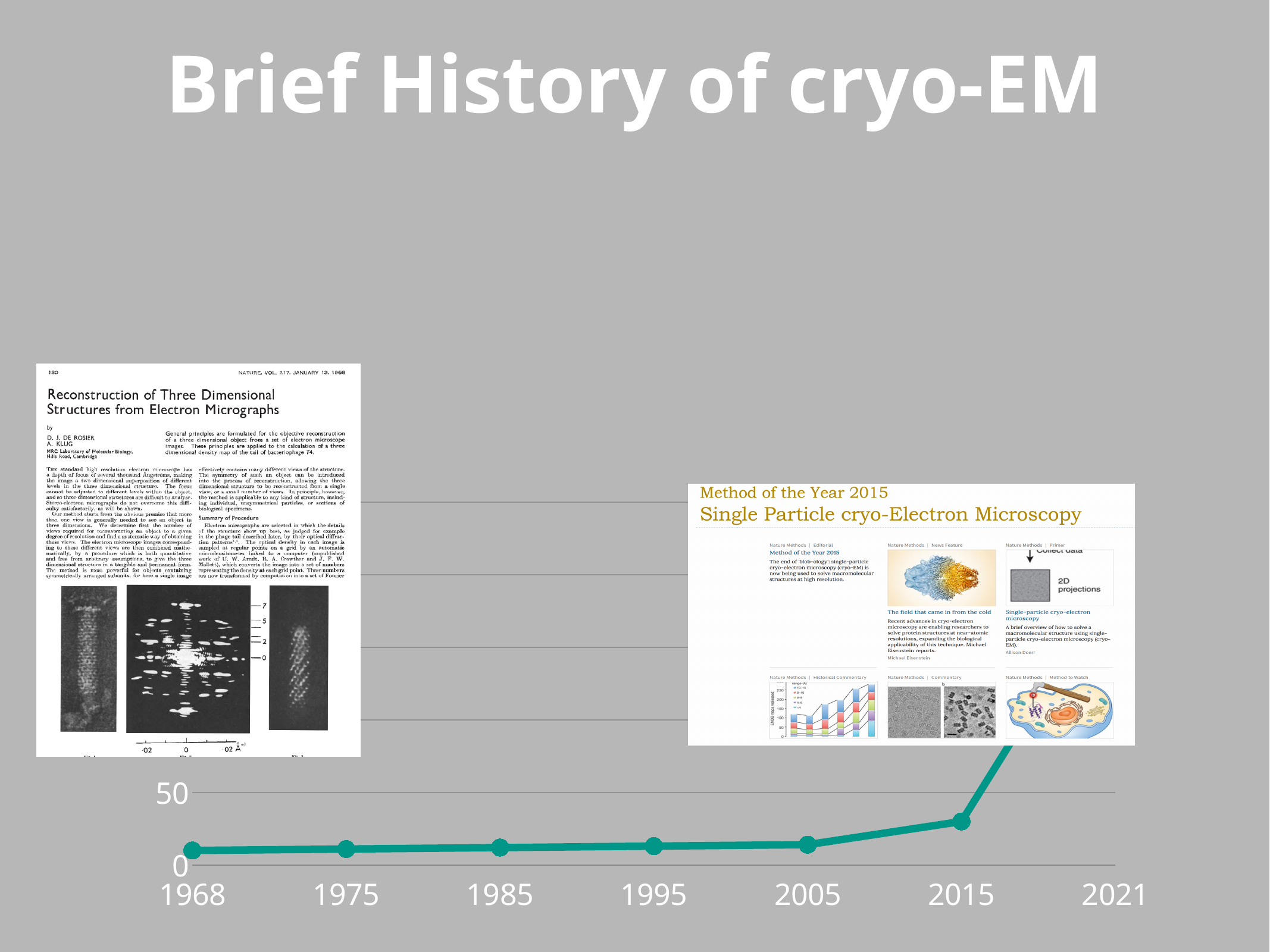
Between which two consecutive x-axis years does the line rise most steeply? 2015 and 2021 Is the value for 1968 greater or less than 50? less Do the values rise or fall along the x axis from 1968 to 2021? rise What is the first year shown on the x axis of the chart? 1968 Which has the larger value, 2005 or 2015? 2015 Is the value for 2021 greater or less than 50? greater Is the value for 2015 greater or less than 50? less How many year labels are shown on the x axis of the chart? 7 Which has the larger value, 1968 or 2015? 2015 What is the title of the slide containing the chart? Brief History of cryo-EM What kind of chart is shown on the slide? line chart